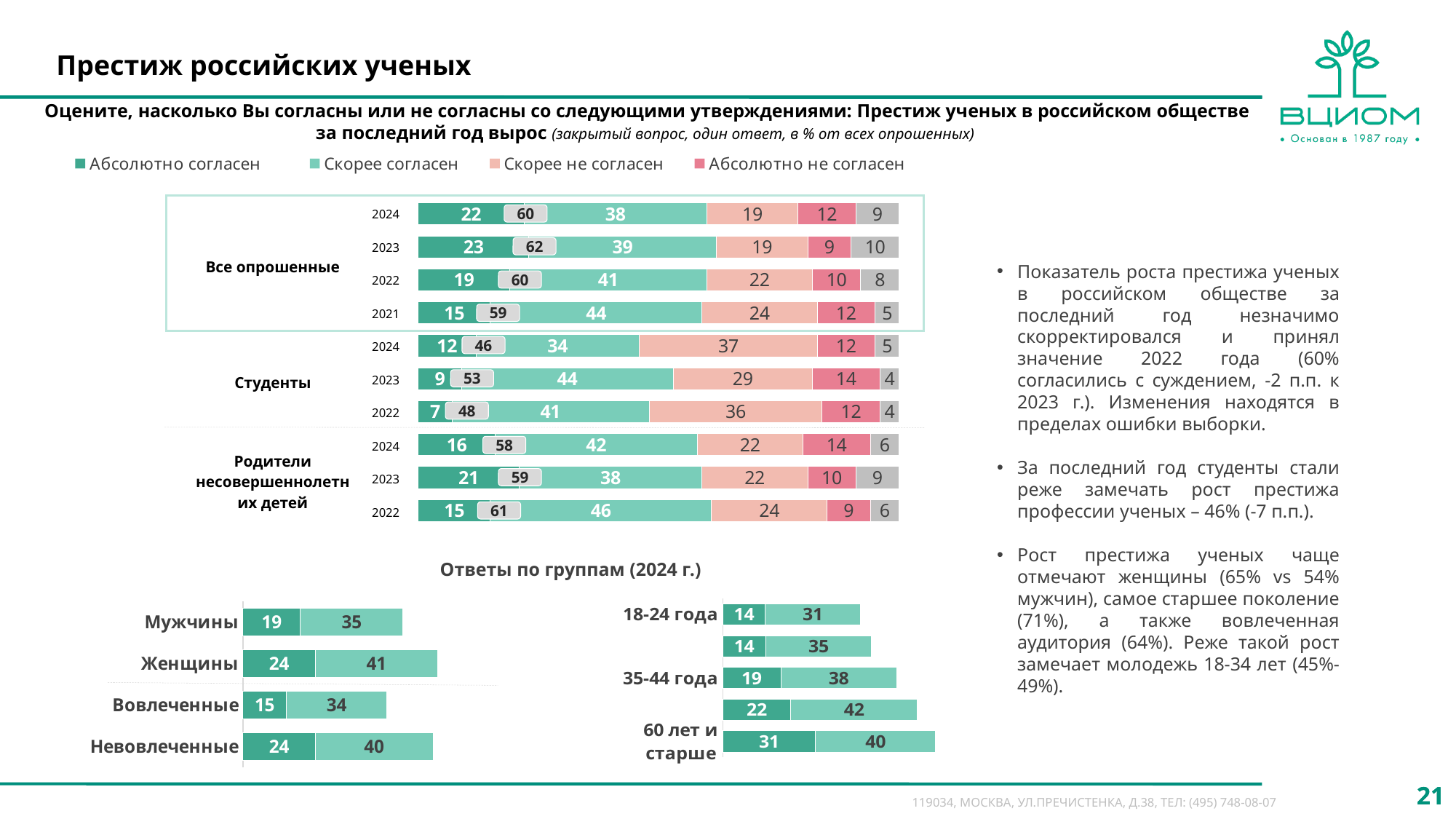
In the top stacked bar chart, what is the value for 'Скорее согласен' among 'Родители несовершеннолетних детей' in 2022? 46 In the top stacked bar chart, which group had the larger 'Скорее не согласен' value in 2023: 'Студенты' or 'Родители несовершеннолетних детей'? Студенты In the bottom-left chart 'Ответы по группам (2024 г.)', what is the 'Скорее согласен' value for 'Женщины'? 41 In the top stacked bar chart, what is the value for 'Скорее не согласен' among 'Студенты' in 2024? 37 How many series does the legend of the top chart list? 4 In the top stacked bar chart, what is the difference between 'Скорее согласен' and 'Абсолютно согласен' for 'Все опрошенные' in 2024? 16 In the bottom-left chart 'Ответы по группам (2024 г.)', which category has the lowest 'Абсолютно согласен' value? Вовлеченные In the top stacked bar chart, how does the 'Абсолютно согласен' value for 'Студенты' change from 2022 to 2024? It rises In the bottom-right chart by age group, what is the 'Абсолютно согласен' value for '60 лет и старше'? 31 What kind of chart is the top chart on the slide? Stacked bar chart In the bottom-right chart by age group, what is the total of the two segments for '35-44 года'? 57 In the top stacked bar chart, what is the value for 'Абсолютно согласен' among 'Все опрошенные' in 2024? 22